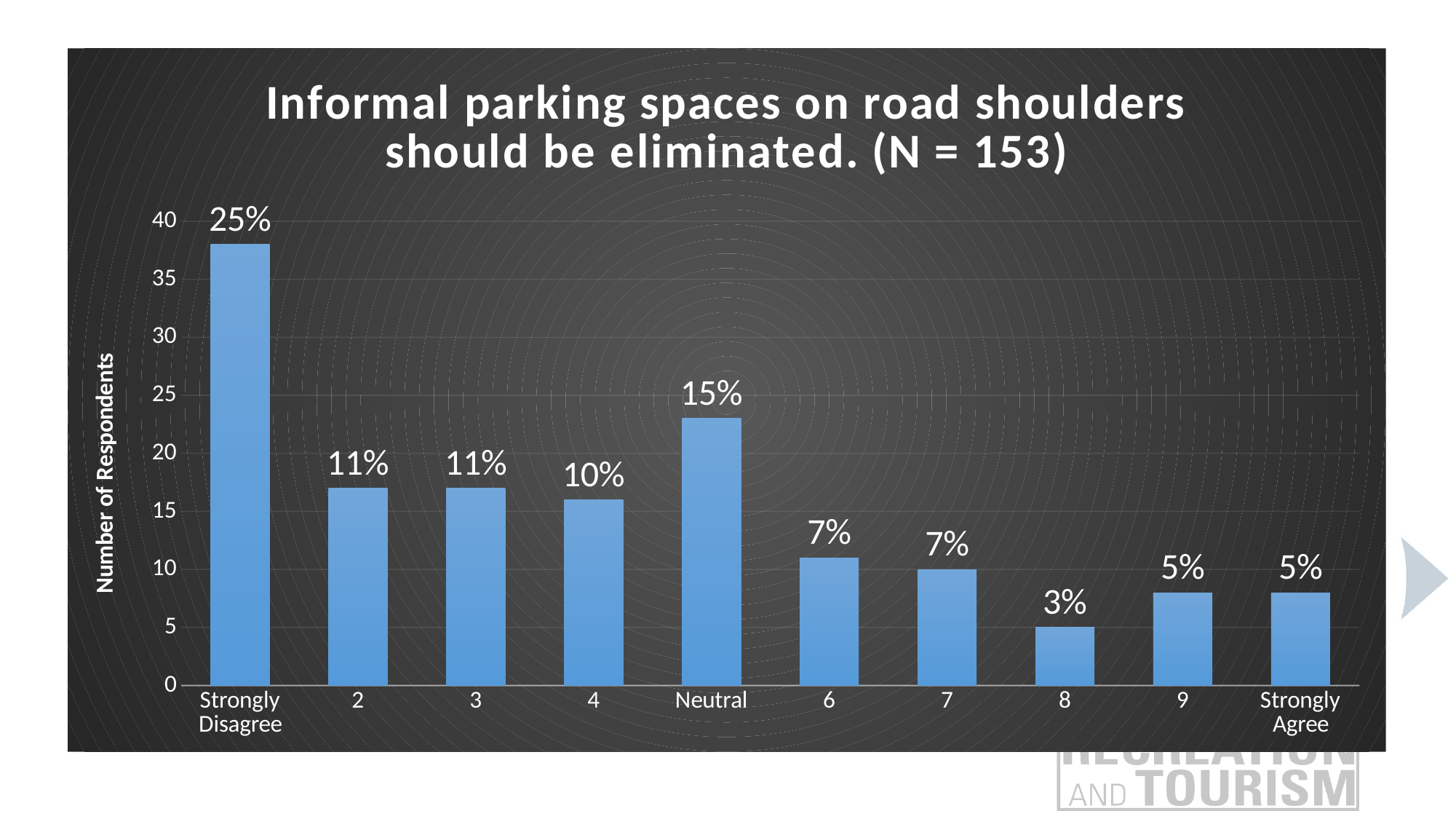
Which has a larger value, Neutral or category 4? Neutral What kind of chart is this? bar chart What is the label of the y axis? Number of Respondents What percentage label is shown on the Strongly Disagree bar? 25% How many categories are shown on the x axis? 10 Is the number of respondents for category 6 greater or less than 15? less Is the number of respondents for Strongly Disagree greater or less than 35? greater What percentage label is shown on the Neutral bar? 15% What percentage label is shown on the bar for category 8? 3% What is the difference between the percentage labels for Strongly Disagree and Neutral? 10% Which category has the lowest bar? 8 Which category has the highest bar? Strongly Disagree